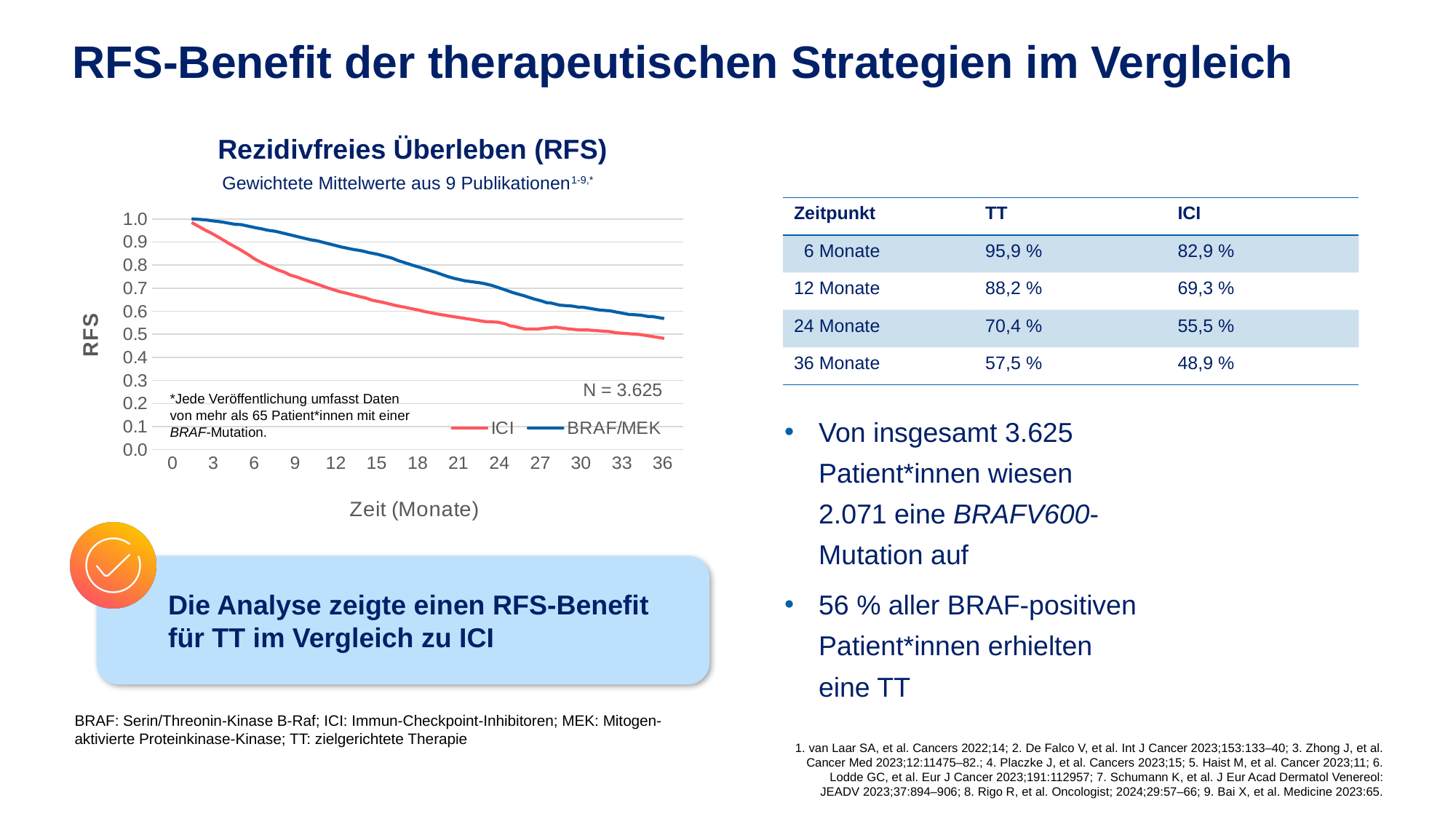
According to the table next to the RFS chart, what is the difference between the TT and ICI values at 36 Monate? 8,6 % How many series does the legend of the RFS chart list? 2 According to the table next to the RFS chart, what is the RFS value for TT at 24 Monate? 70,4 % Do the RFS values for the ICI series rise or fall as time increases along the x axis? fall Is the RFS value for the BRAF/MEK series at 36 months greater or less than 0.5? greater Is the RFS value for the ICI series at 36 months greater or less than 0.5? less Which series in the RFS chart has the higher value at 36 months, ICI or BRAF/MEK? BRAF/MEK According to the table next to the RFS chart, what is the RFS value for ICI at 12 Monate? 69,3 % Is the RFS value for the BRAF/MEK series at 12 months greater or less than 0.8? greater Which two series are listed in the legend of the RFS chart? ICI and BRAF/MEK What kind of chart is shown under the title "Rezidivfreies Überleben (RFS)"? line chart What is the label of the x axis of the RFS chart? Zeit (Monate)